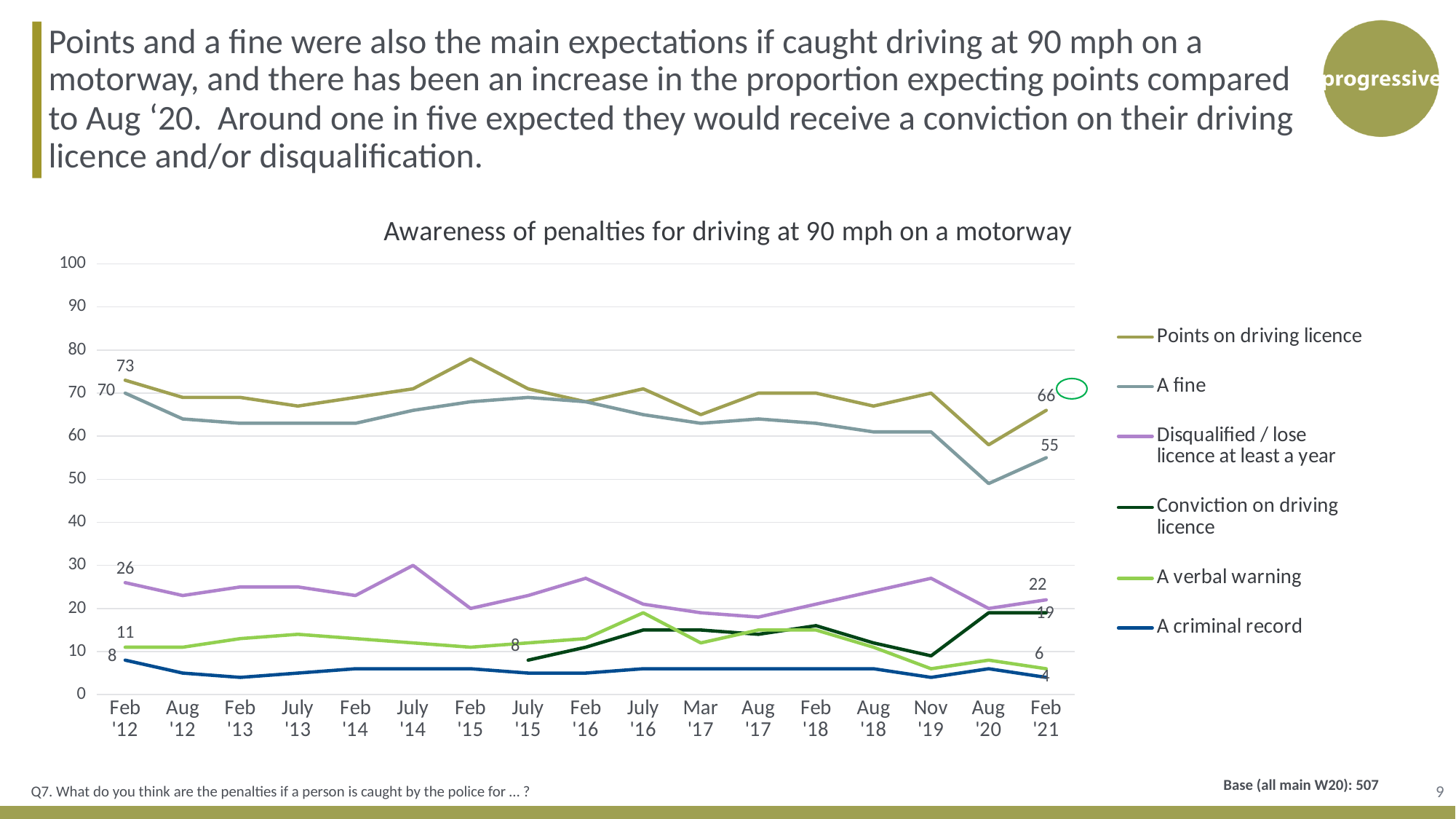
What is the value for A criminal record in Feb '21? 4 Is the value for Points on driving licence in Feb '15 greater or less than 70? greater How many series does the legend list? 6 What is the value for Disqualified / lose licence at least a year in Feb '12? 26 Which series has the highest value in Feb '21? Points on driving licence What is the value for Conviction on driving licence in July '15? 8 What is the value for Points on driving licence in Feb '12? 73 What kind of chart is shown on the slide? Line chart By how much did Points on driving licence fall from Feb '12 to Feb '21? 7 What is the value for A fine in Feb '21? 55 In Feb '21, what is the difference between Points on driving licence and A fine? 11 How many time points are shown along the x axis? 17